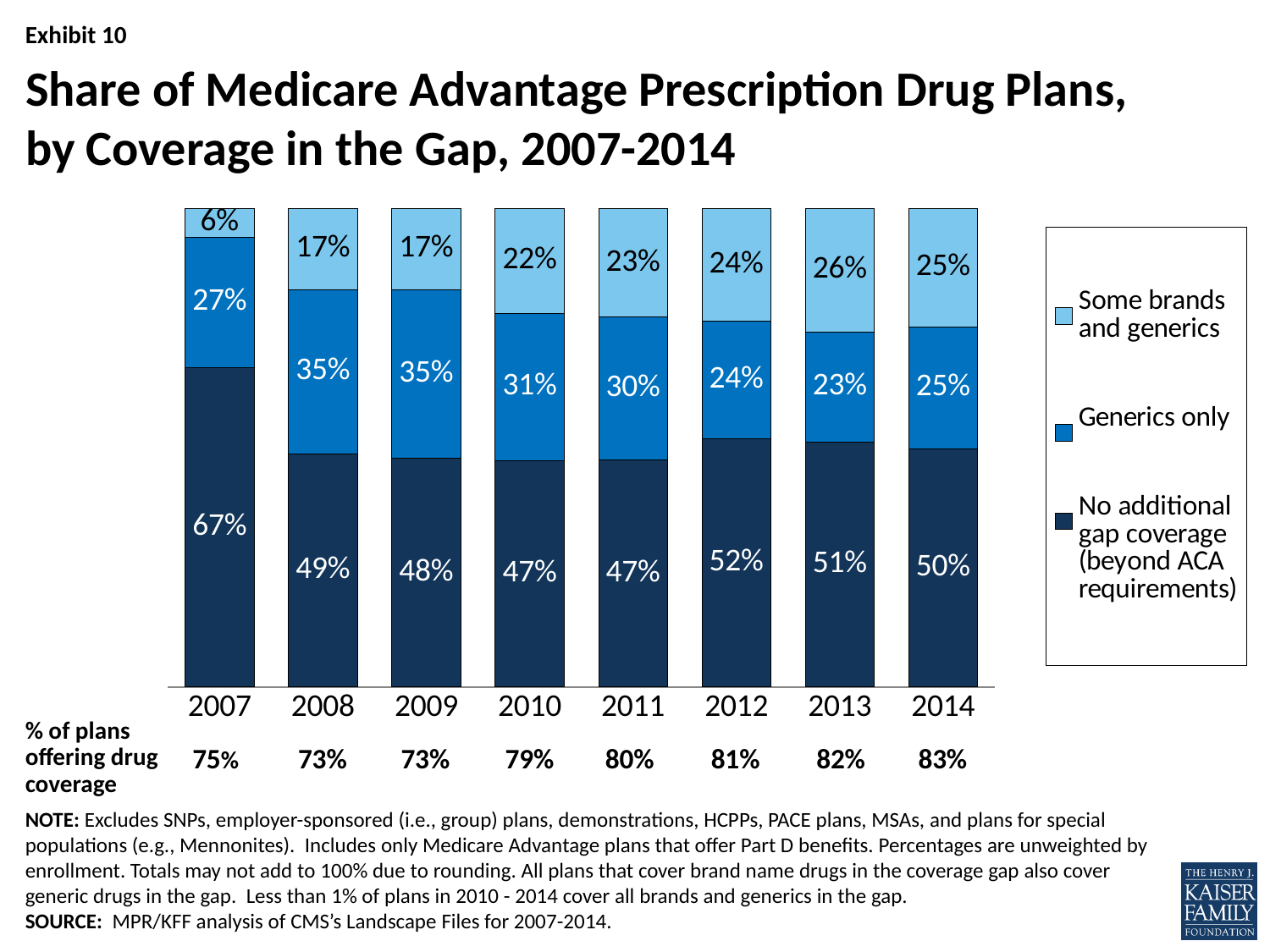
What share of plans covered generics only in 2010? 31% How many years are shown along the x axis? 8 In which year was the share of plans with no additional gap coverage highest? 2007 Which is larger: the generics-only share in 2009 or the generics-only share in 2012? 2009 What share of plans had no additional gap coverage in 2007? 67% What share of plans covered some brands and generics in 2013? 26% What is the total of the three segments for the 2012 bar? 100% How many series does the legend list? 3 In which year was the share of plans covering some brands and generics lowest? 2007 What kind of chart is shown on the slide? Stacked bar chart Does the share of plans covering some brands and generics generally rise or fall from 2007 to 2014? Rise What is the difference between the generics-only share in 2008 and in 2014? 10 percentage points